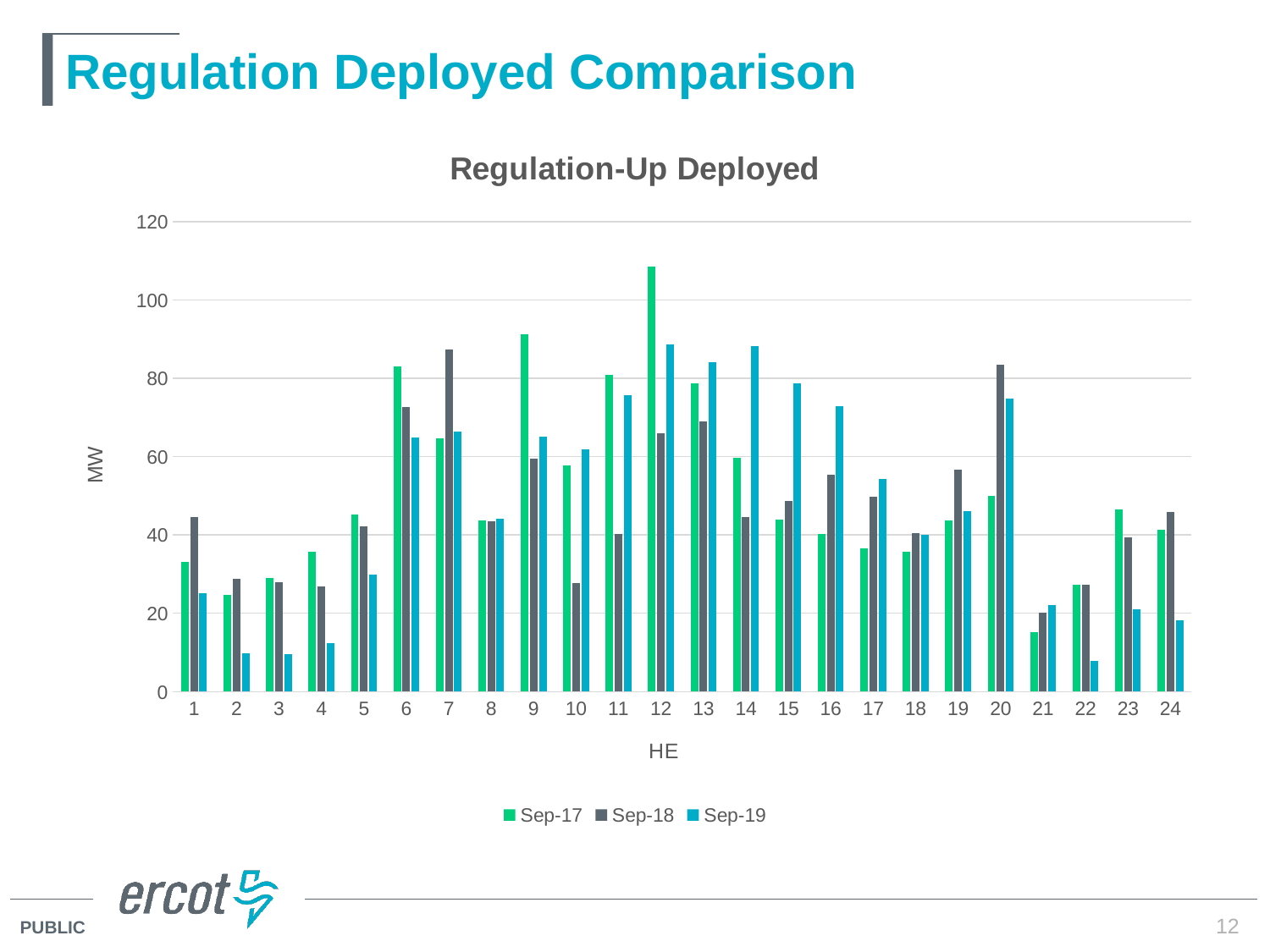
For the Sep-17 series, which HE has the lowest value? 21 What kind of chart is shown on the slide? bar chart What is the title of the chart? Regulation-Up Deployed At HE 14, which series has the larger value, Sep-17 or Sep-19? Sep-19 At HE 20, which series has the larger value, Sep-17 or Sep-18? Sep-18 For the Sep-17 series, which HE has the highest value? 12 How many series does the legend list? 3 Is the Sep-17 value at HE 12 greater or less than 100? greater Is the Sep-19 value at HE 22 greater or less than 20? less What unit is shown on the y axis label? MW How many hour-ending (HE) categories are shown on the x axis? 24 For the Sep-18 series, which HE has the lowest value? 21